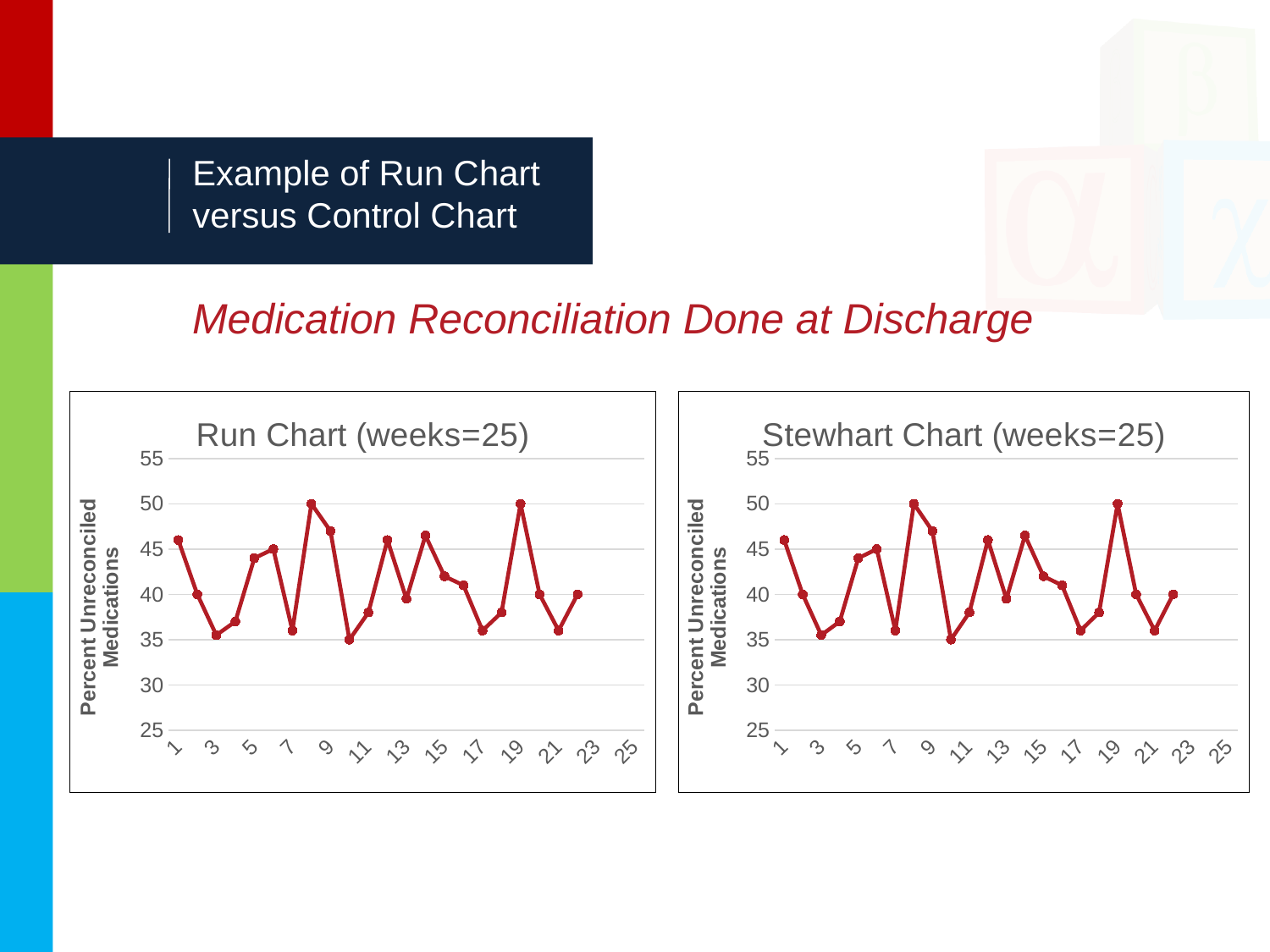
What is the y-axis label of the Run Chart (weeks=25)? Percent Unreconciled Medications What type of chart is the Run Chart (weeks=25) on the left? line chart In the Run Chart (weeks=25), what is the value at week 8? 50 In the Stewhart Chart (weeks=25), which is larger, the value at week 10 or the value at week 12? week 12 In the Stewhart Chart (weeks=25), is the value at week 17 greater or less than 40? less What type of chart is the Stewhart Chart (weeks=25) on the right? line chart In the Stewhart Chart (weeks=25), what is the value at week 19? 50 In the Run Chart (weeks=25), is the value at week 9 greater or less than 45? greater In the Run Chart (weeks=25), which is larger, the value at week 8 or the value at week 7? week 8 In the Stewhart Chart (weeks=25), what is the highest value reached on the line? 50 In the Run Chart (weeks=25), what is the value at week 10? 35 What is the title of the chart on the right side of the slide? Stewhart Chart (weeks=25)